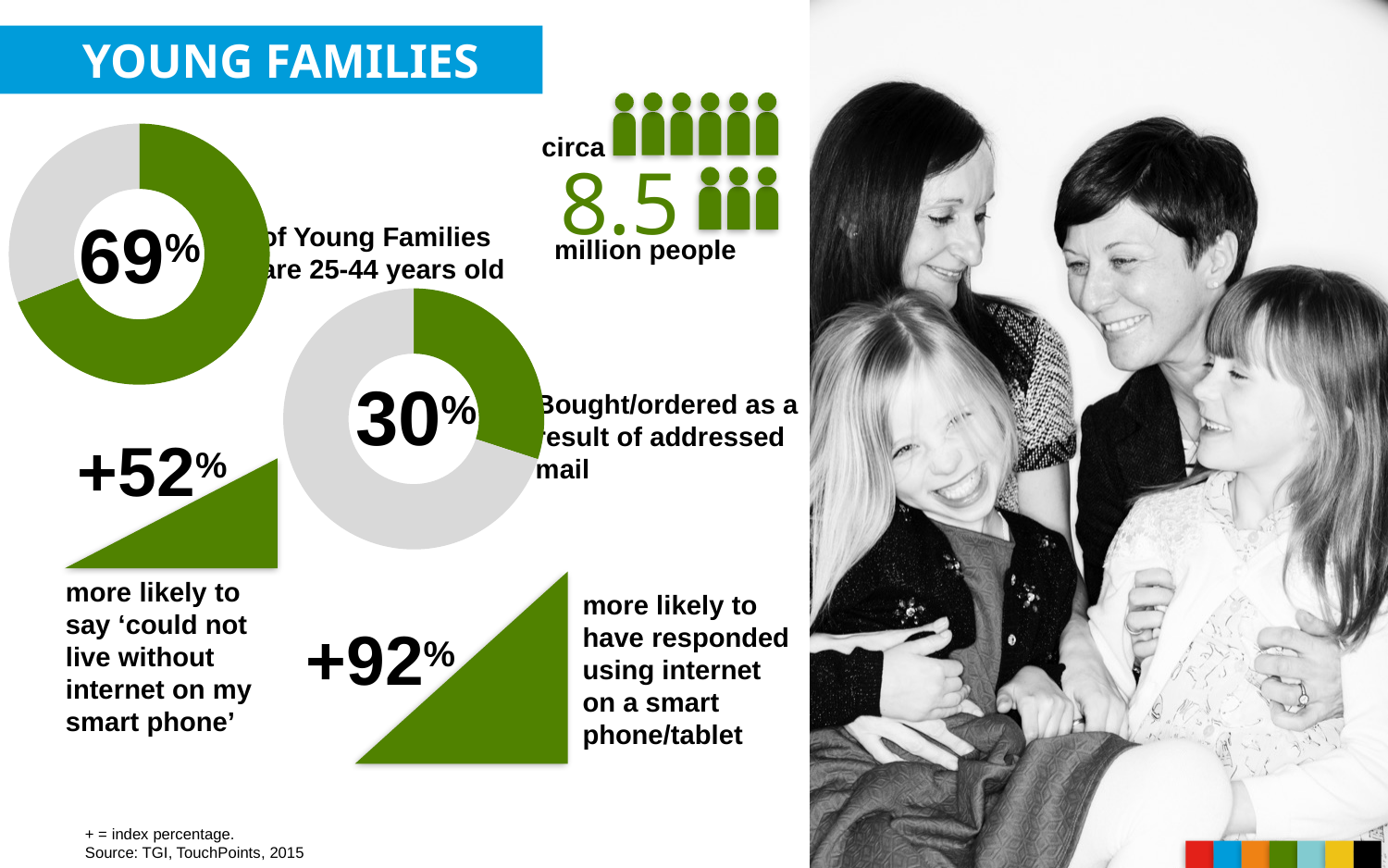
What kind of chart is used to show the 69% figure for Young Families aged 25-44? Donut (pie) chart What is the title of the slide containing the donut charts? YOUNG FAMILIES In the upper-left donut chart, what share of the ring is left grey (not aged 25-44)? 31% In the middle donut chart, what share of the ring is filled green for those who bought/ordered as a result of addressed mail? 30% In the middle donut chart, what percentage of Young Families bought/ordered as a result of addressed mail? 30% What is the difference in percentage points between the 25-44 years old donut chart value and the bought/ordered as a result of addressed mail donut chart value? 39 percentage points What colour is used for the filled (highlighted) segment in both donut charts? Green How many donut charts are shown on the slide? 2 In the middle donut chart, is the green filled portion greater or less than 50% of the ring? less Which is larger: the share of Young Families aged 25-44 or the share who bought/ordered as a result of addressed mail? Share aged 25-44 (69%) In the upper-left donut chart, is the green filled portion greater or less than 50% of the ring? greater In the upper-left donut chart, what percentage of Young Families are 25-44 years old? 69%